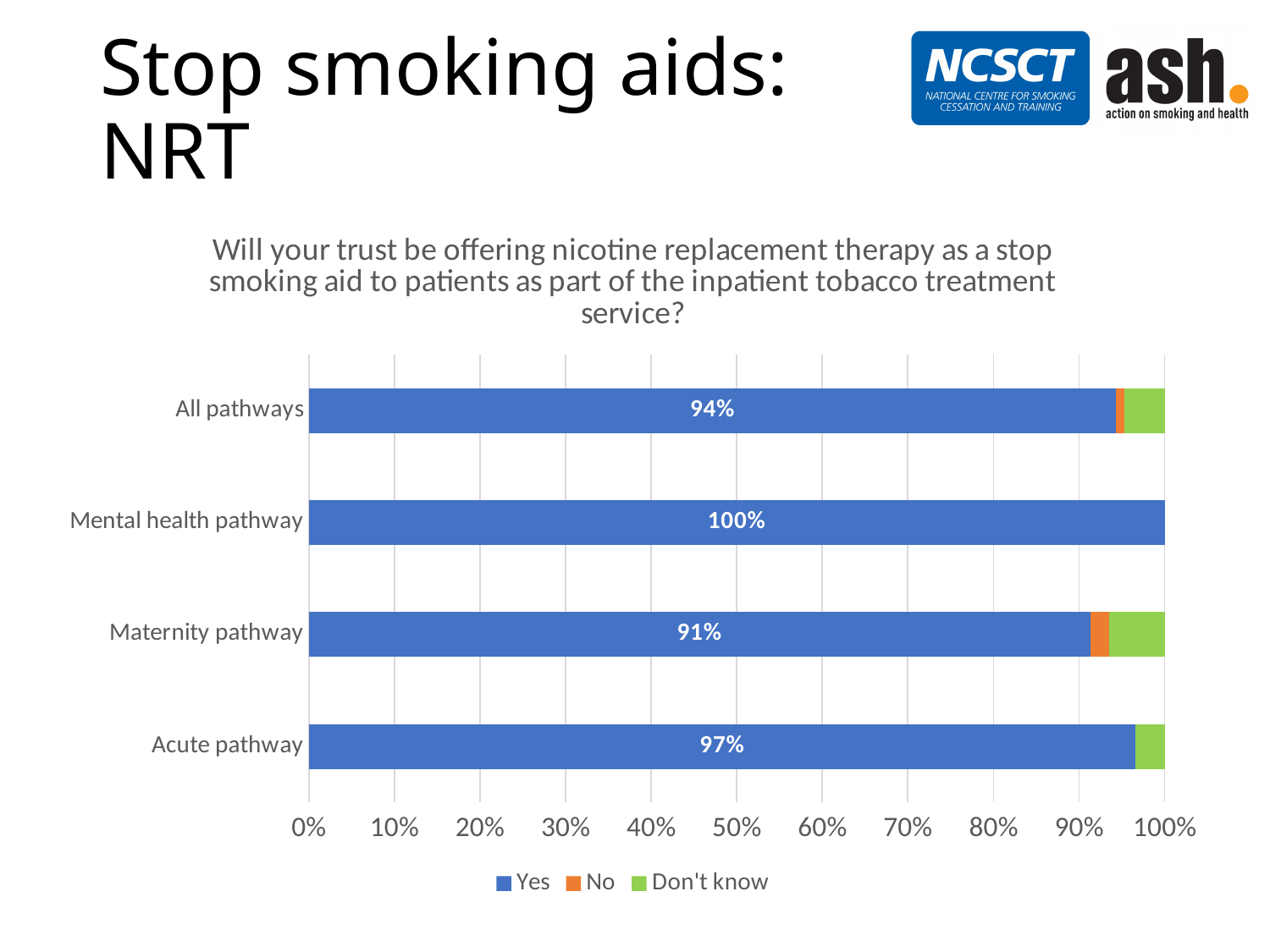
Which has a larger Yes value, the Acute pathway or All pathways? Acute pathway Which pathway has the lowest Yes percentage? Maternity pathway How many pathway categories are shown on the chart? 4 What is the Yes value for the Acute pathway? 97% How many series does the legend list? 3 What kind of chart is shown on the slide? Stacked bar chart What percentage of trusts in the Mental health pathway answered Yes? 100% What is the Yes value for the Maternity pathway? 91% What is the difference between the Yes value for the Acute pathway and the Maternity pathway? 6% What is the Yes value for All pathways? 94% Which series is shown in green in the legend? Don't know Which pathway has the highest Yes percentage? Mental health pathway